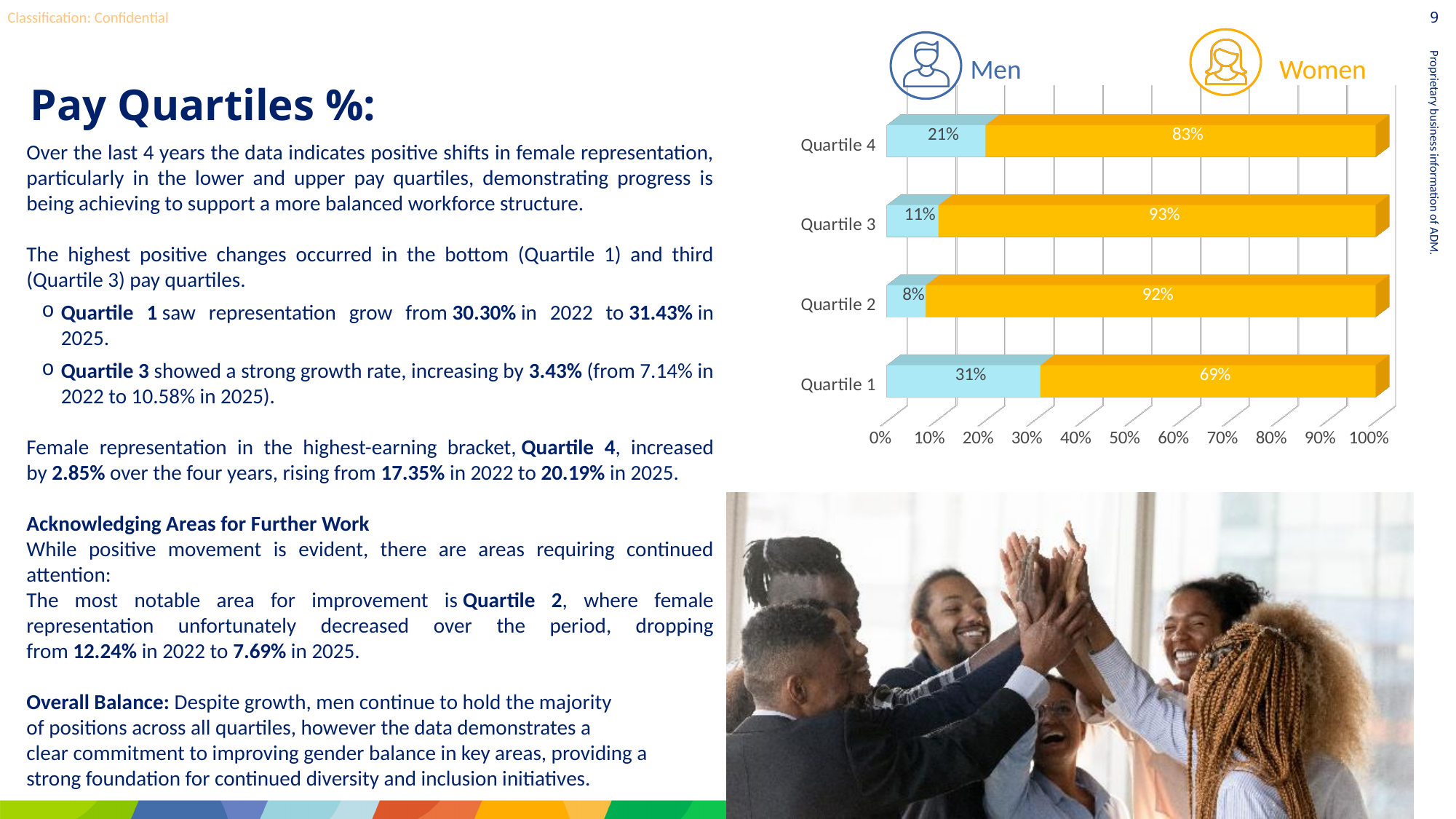
Which quartile has the lowest value for Men? Quartile 1 Which is larger: the Women value in Quartile 2 or the Women value in Quartile 1? Quartile 1 What colour represents the Women series in the chart? Blue How many quartile categories are plotted in the chart? 4 What is the difference between the Men value in Quartile 4 and the Men value in Quartile 3? 10% What is the value for Women in Quartile 3? 11% What type of chart is shown on the slide? Bar chart What is the value for Women in Quartile 4? 21% What is the value for Men in Quartile 2? 92% What is the value for Men in Quartile 1? 69% Which quartile has the highest value for Men? Quartile 3